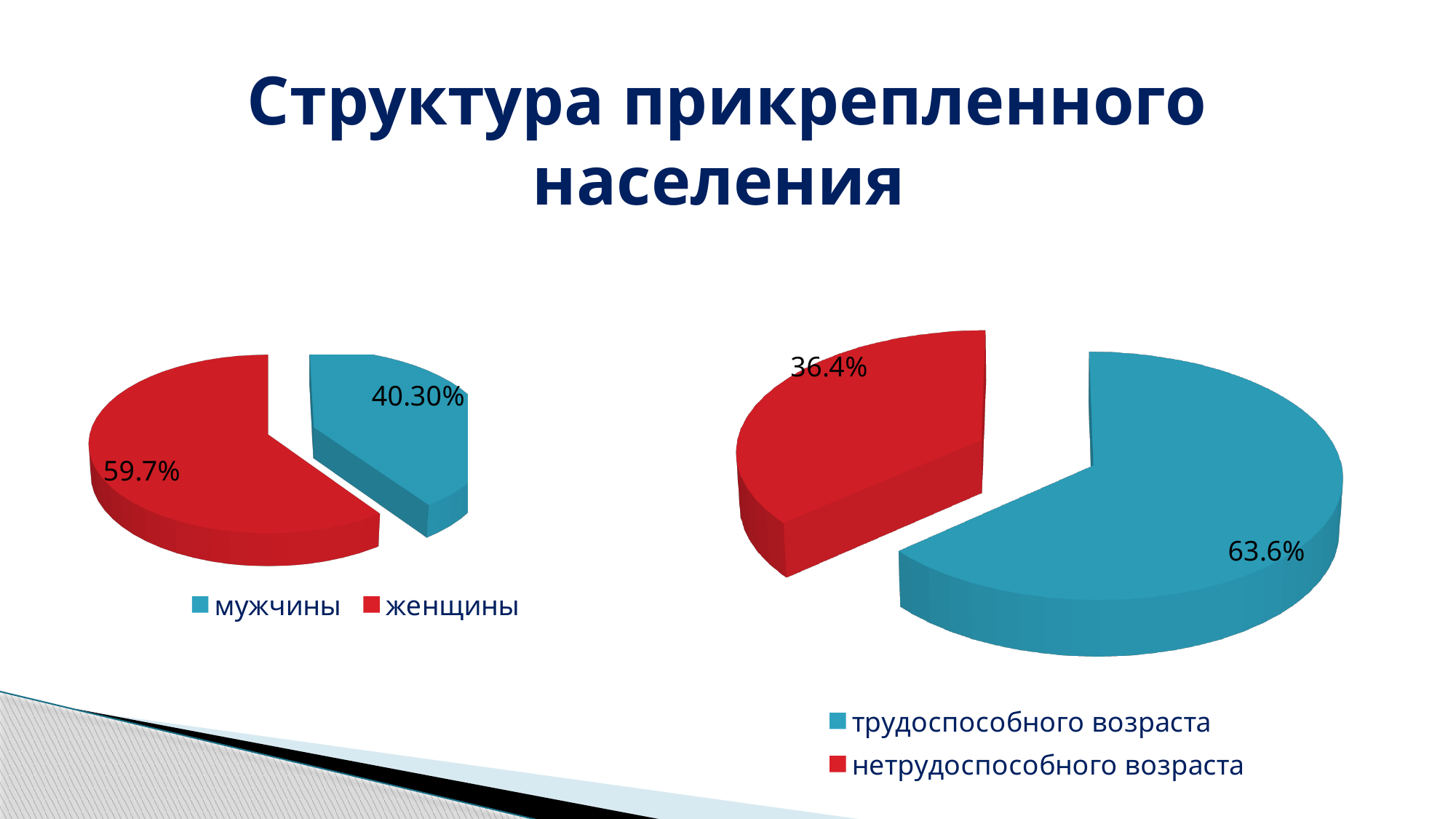
How many slices does the right pie chart have? 2 In the right pie chart, what is the value for трудоспособного возраста? 63.6% In the right pie chart, which category has the smallest share? нетрудоспособного возраста In the left pie chart, what is the difference between женщины and мужчины? 19.4% In the left pie chart, what is the value for женщины? 59.7% In the right pie chart, what is the difference between трудоспособного возраста and нетрудоспособного возраста? 27.2% In the right pie chart, what is the value for нетрудоспособного возраста? 36.4% In the left pie chart, what is the value for мужчины? 40.30% What colour is the slice for нетрудоспособного возраста in the right pie chart? Red In the left pie chart, which is larger: мужчины or женщины? женщины In the left pie chart, which category has the largest share? женщины What type of chart is the left chart? Pie chart